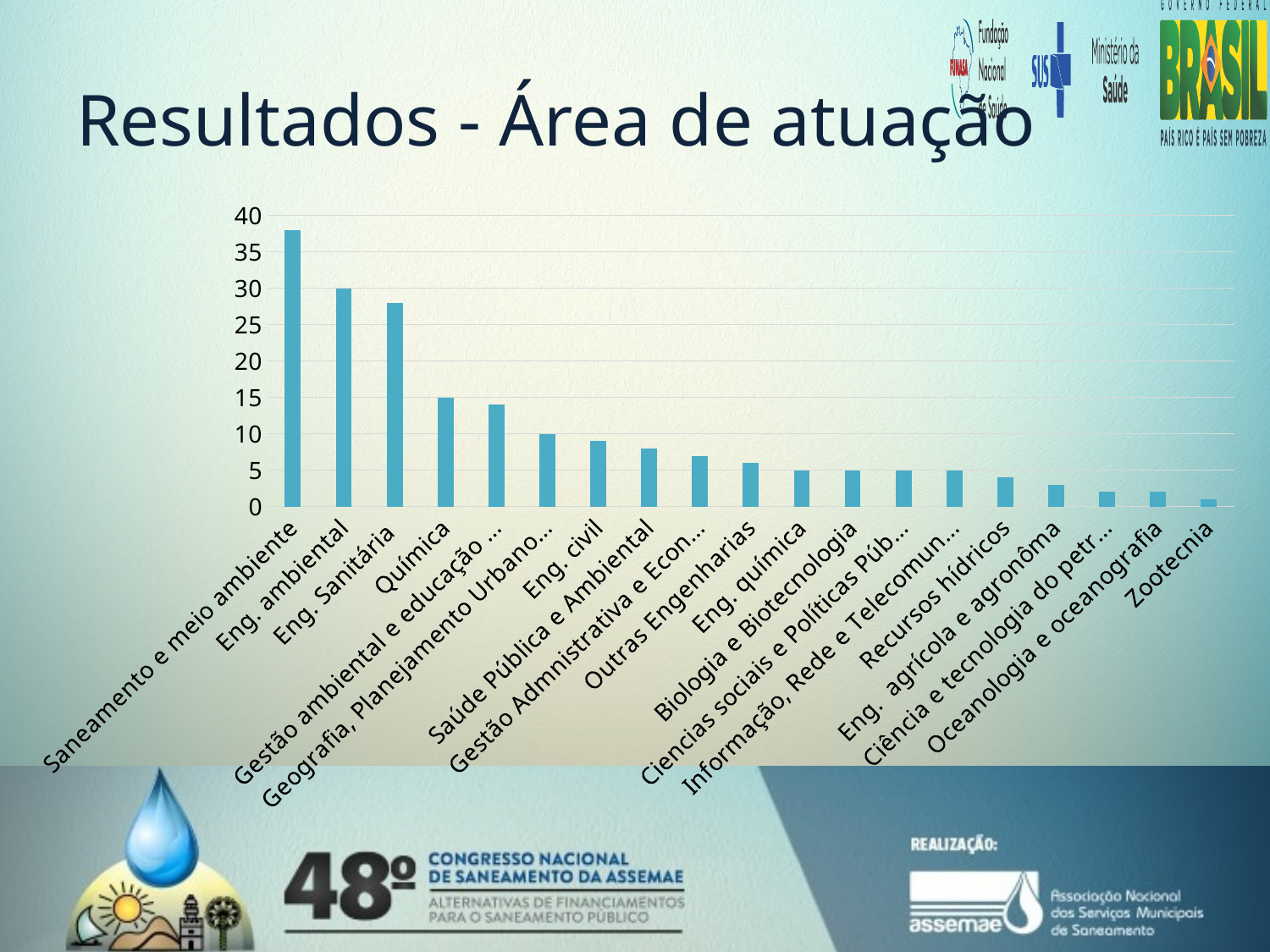
Is the value for Recursos hídricos greater or less than 5? less Is the value for Eng. civil greater or less than 10? less What is the title of the slide containing the chart? Resultados - Área de atuação What kind of chart is shown on the slide? bar chart Which area has the highest value in the chart? Saneamento e meio ambiente Which is larger, the value for Eng. ambiental or the value for Química? Eng. ambiental How many areas (bars) are shown in the chart? 19 Which is larger, the value for Zootecnia or the value for Eng. agrícola e agronôma? Eng. agrícola e agronôma Do the bar values generally rise or fall from left to right along the x axis? fall Is the value for Eng. Sanitária greater or less than 25? greater Which area has the lowest value in the chart? Zootecnia